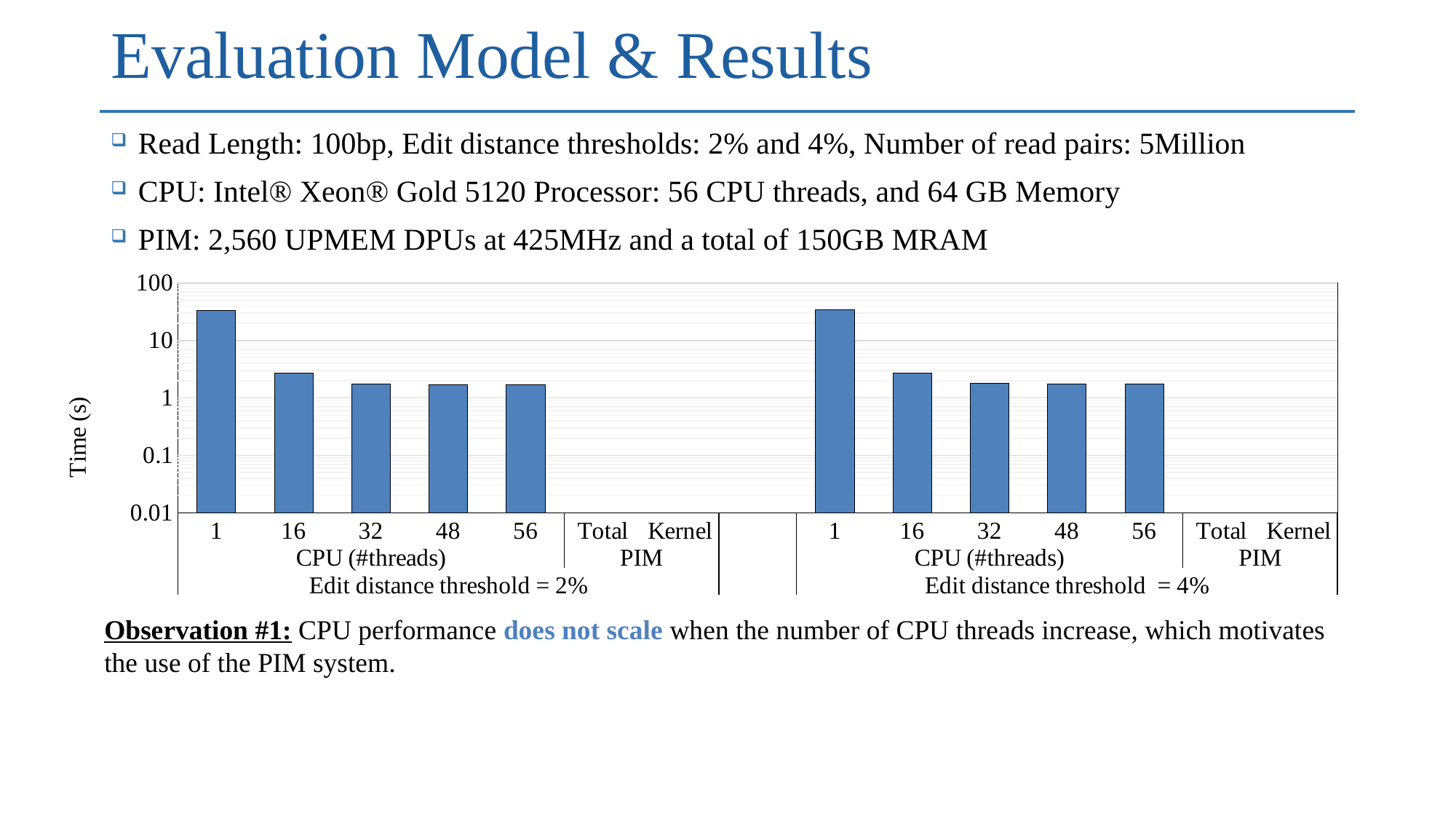
In the Edit distance threshold = 2% group, which CPU thread count has the highest time? 1 Is the time for 16 CPU threads at Edit distance threshold = 2% greater or less than 1? greater At Edit distance threshold = 4%, which has the larger time: 16 CPU threads or 56 CPU threads? 16 What kind of chart is shown on the slide? bar chart In the Edit distance threshold = 4% group, which CPU thread count has the highest time? 1 Is the time for 1 CPU thread at Edit distance threshold = 2% greater or less than 10? greater Is the time for 32 CPU threads at Edit distance threshold = 4% greater or less than 10? less As the number of CPU threads increases from 1 to 56 at Edit distance threshold = 2%, does the time rise or fall? fall How many CPU thread counts are listed on the x axis for each edit distance threshold group? 5 At Edit distance threshold = 2%, which has the larger time: 1 CPU thread or 16 CPU threads? 1 What is the label of the y axis? Time (s)